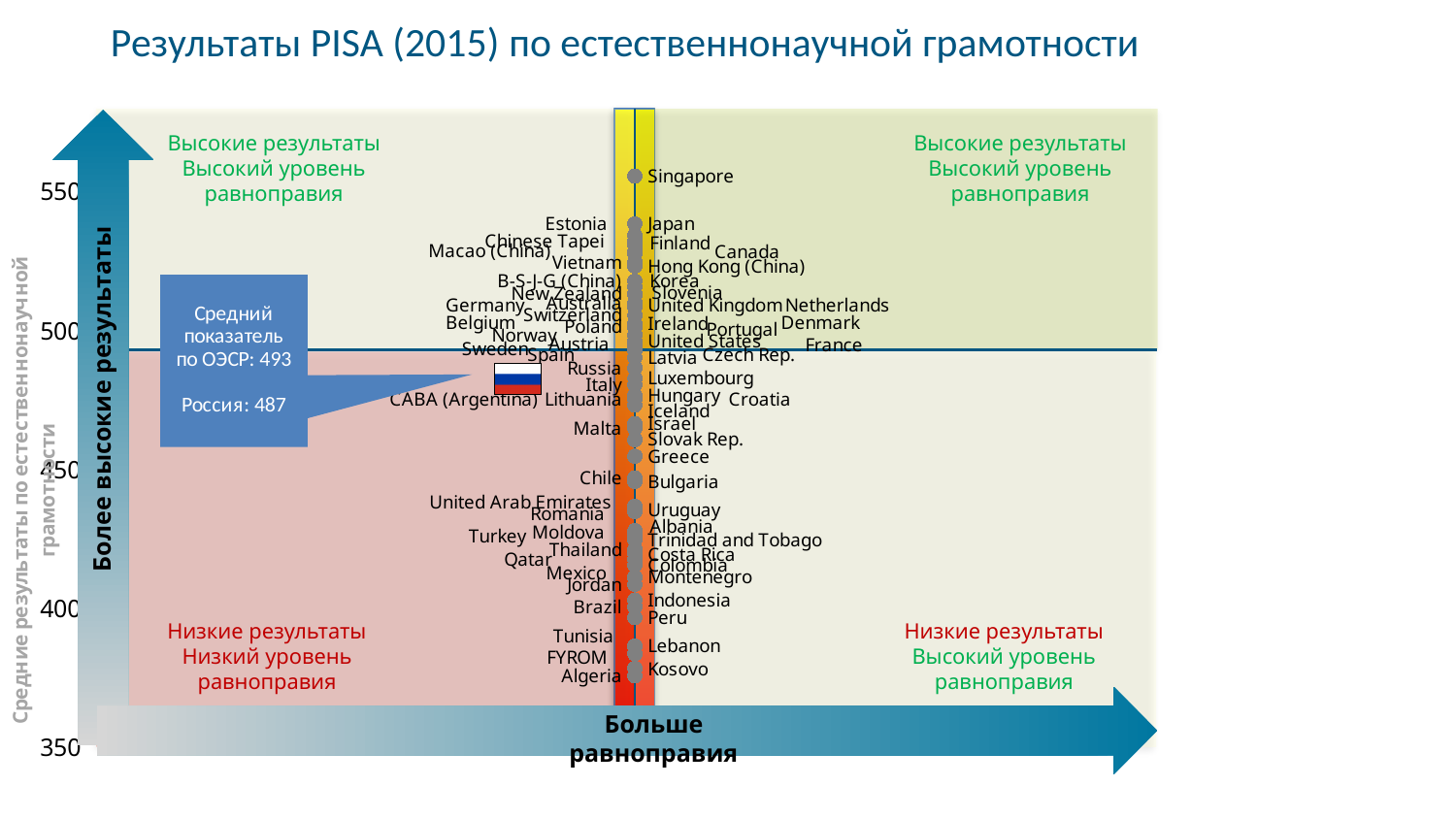
Which country is plotted higher on the chart, Singapore or Japan? Singapore What is the title of the chart on the slide? Результаты PISA (2015) по естественнонаучной грамотности Is the value for Brazil greater or less than 450? less Which is larger: the OECD average score or Russia's score? OECD average Is the value for Kosovo greater or less than 400? less Which country has the highest PISA science result on the chart? Singapore What kind of chart is shown on the slide? scatter chart What is the label of the vertical axis on the left of the chart? Средние результаты по естественнонаучной грамотности Is the value for Singapore greater or less than 500? greater What is Russia's score shown in the callout? 487 What is the difference between the OECD average score and Russia's score? 6 What is the average OECD score (Средний показатель по ОЭСР) shown in the callout? 493